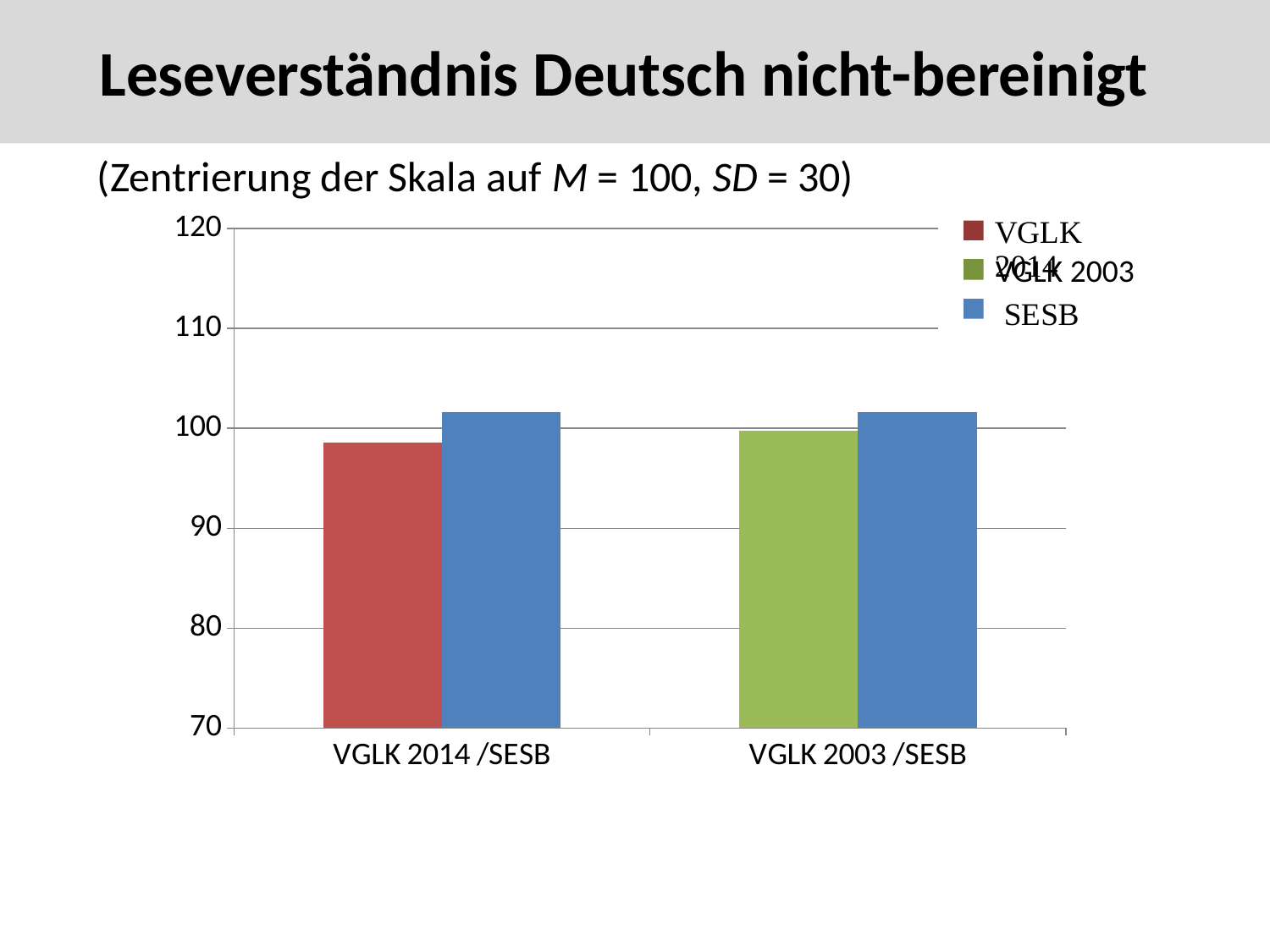
Is the value for VGLK 2003 in the 'VGLK 2003 /SESB' group greater or less than 90? greater In the 'VGLK 2014 /SESB' group, which bar is taller, VGLK 2014 or SESB? SESB Is the value for SESB in the 'VGLK 2014 /SESB' group greater or less than 100? greater What colour are the SESB bars in the chart? blue What kind of chart is shown on the slide? bar chart Is the value for SESB in the 'VGLK 2003 /SESB' group greater or less than 100? greater How many series does the chart legend list? 3 Which bar in the chart is the lowest? VGLK 2014 How many categories are shown on the x axis of the chart? 2 What is the title of the slide containing the chart? Leseverständnis Deutsch nicht-bereinigt